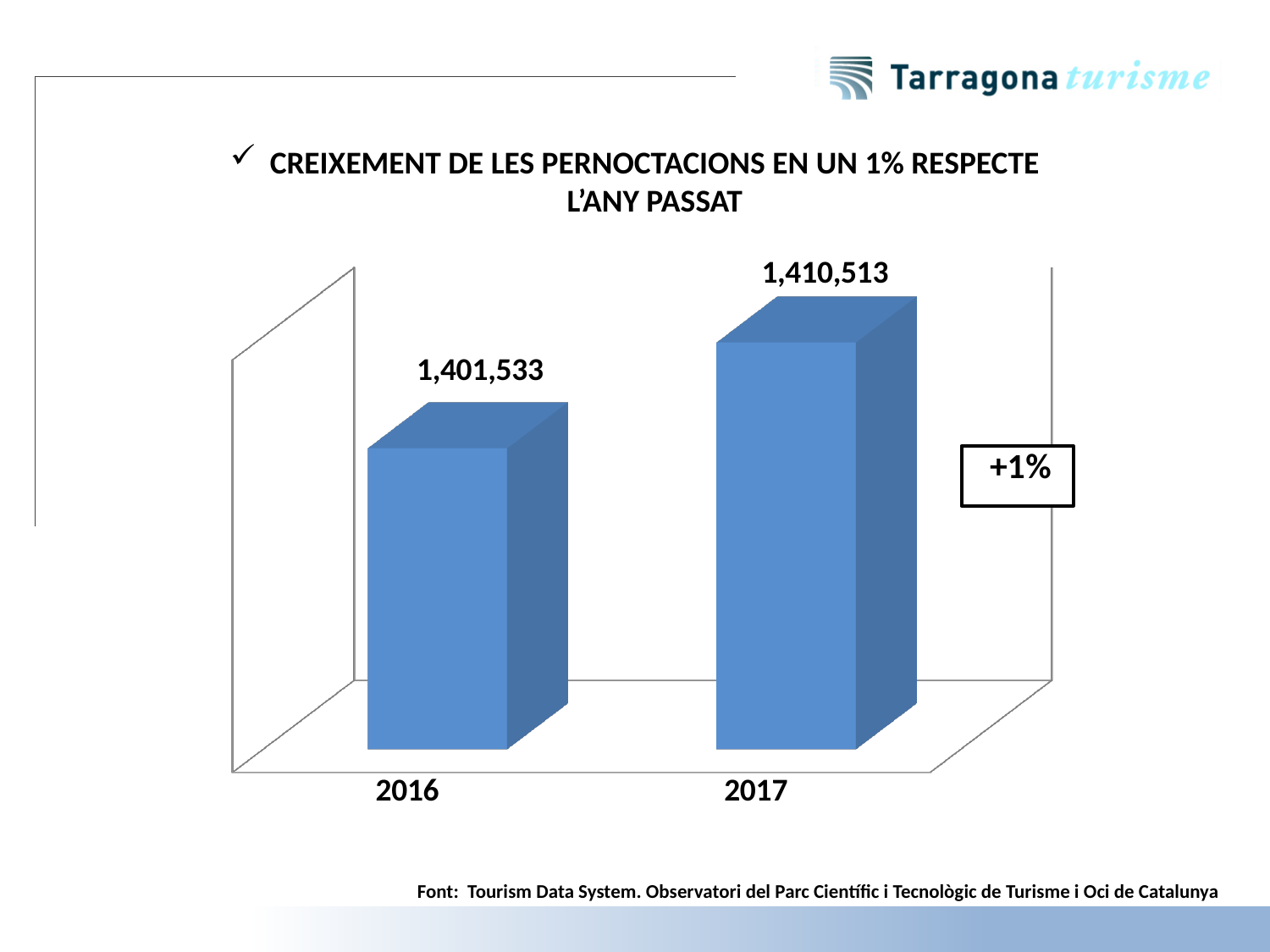
Which year has the highest value? 2017 What kind of chart is shown on the slide? bar chart Which year has the lowest value? 2016 What is the value for 2016? 1,401,533 How many categories are shown on the x axis? 2 What percentage change is shown in the box next to the chart? +1% Which is larger, the value for 2016 or the value for 2017? 2017 What is the difference between the values for 2017 and 2016? 8,980 Do the values rise or fall from 2016 to 2017? rise What colour are the bars in the chart? blue What is the value for 2017? 1,410,513